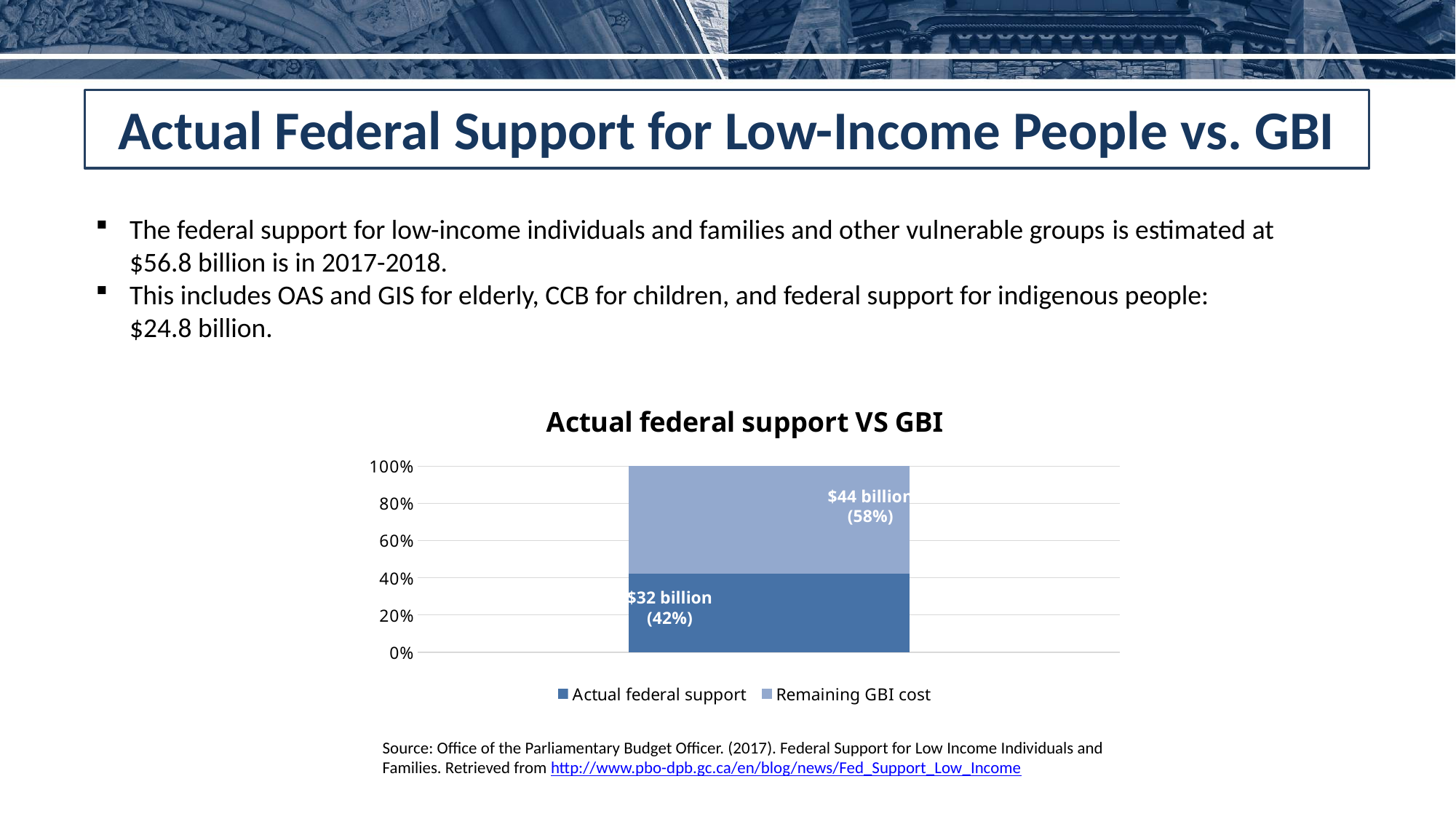
Which series is shown in the darker blue colour? Actual federal support What percentage share does Actual federal support make up of the bar? 42% Is the share for Actual federal support greater or less than 60%? less What type of chart is shown on the slide? Stacked bar chart What is the title of the chart? Actual federal support VS GBI What is the difference in billions between Remaining GBI cost and Actual federal support? $12 billion What is the value labelled for Actual federal support? $32 billion (42%) How many series does the legend list? 2 What is the value labelled for Remaining GBI cost? $44 billion (58%) Which series is larger, Actual federal support or Remaining GBI cost? Remaining GBI cost What percentage share does Remaining GBI cost make up of the bar? 58% What is the total of the stacked bar in billions? $76 billion